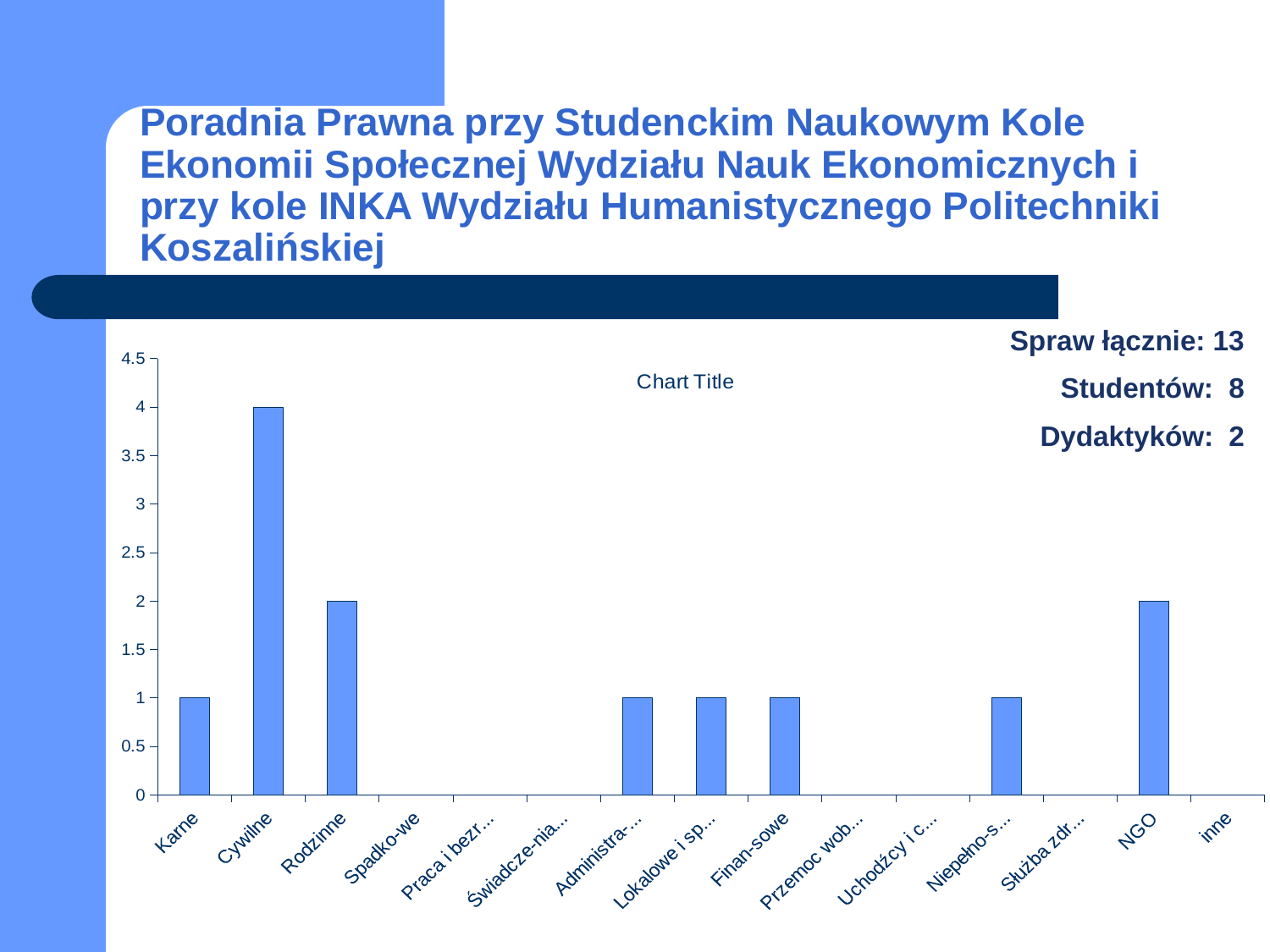
Which category has the highest value? Cywilne What is the value for NGO? 2 What is the difference between the values for Cywilne and Rodzinne? 2 What is the value for Cywilne? 4 Is the value for Cywilne greater or less than 3? greater What is the value for Finan-sowe? 1 What is the value for Rodzinne? 2 What kind of chart is shown on the slide? bar chart Which is larger, the value for NGO or the value for Karne? NGO What is the value for Karne? 1 What is the title of the chart? Chart Title How many categories are shown on the x axis? 15